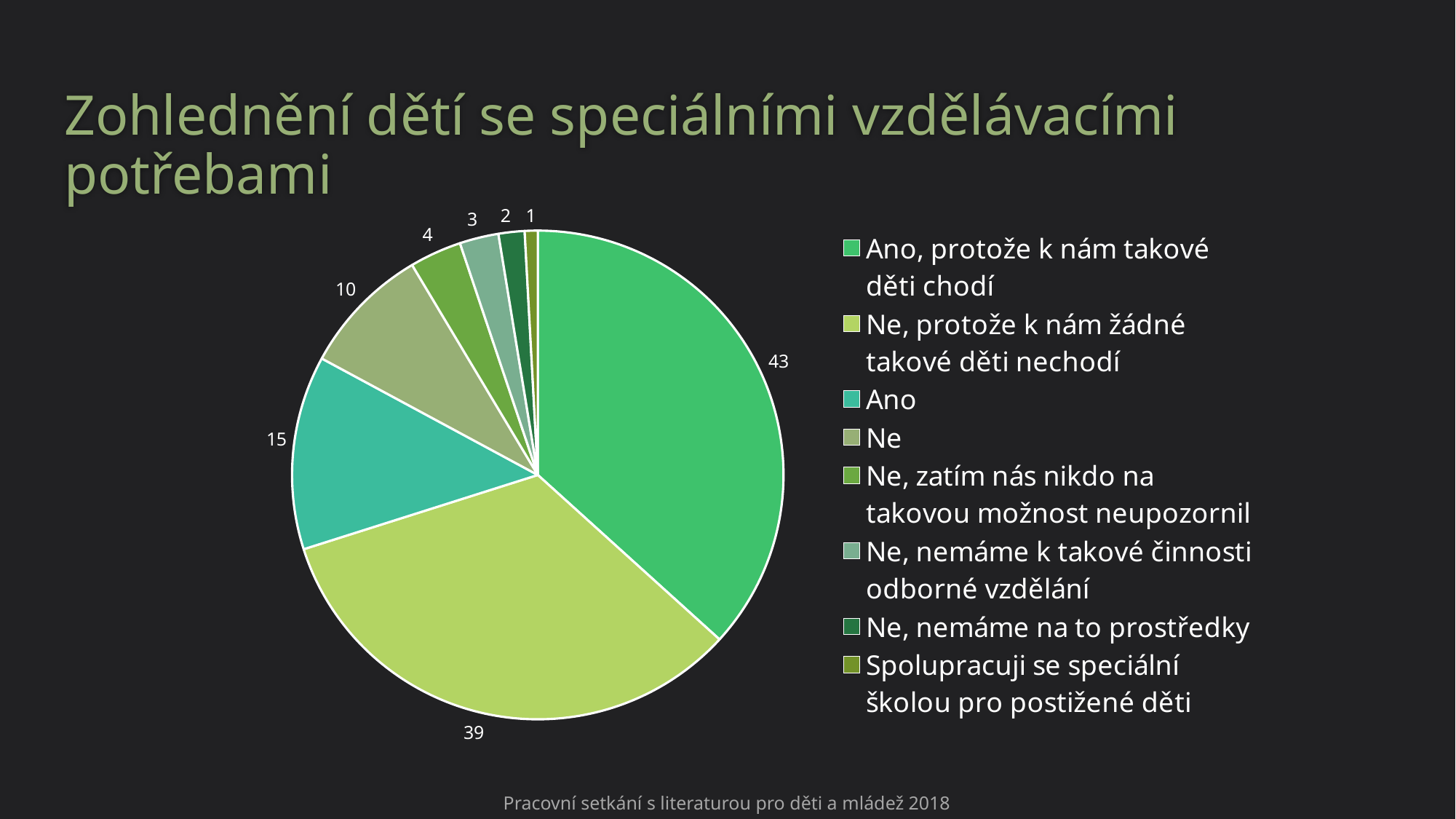
What is the value for "Ano, protože k nám takové děti chodí"? 43 Which category has the largest slice? Ano, protože k nám takové děti chodí What is the title of the chart on the slide? Zohlednění dětí se speciálními vzdělávacími potřebami How many slices does the pie chart have? 8 Which is larger, the value for "Ne" or the value for "Ano"? Ano What is the value for "Ne, nemáme na to prostředky"? 2 Which category has the smallest slice? Spolupracuji se speciální školou pro postižené děti How many entries does the legend list? 8 What is the value for "Ne, protože k nám žádné takové děti nechodí"? 39 What kind of chart is shown on the slide? pie chart What is the difference between the values for "Ano, protože k nám takové děti chodí" and "Ne, protože k nám žádné takové děti nechodí"? 4 What is the value for "Ano"? 15